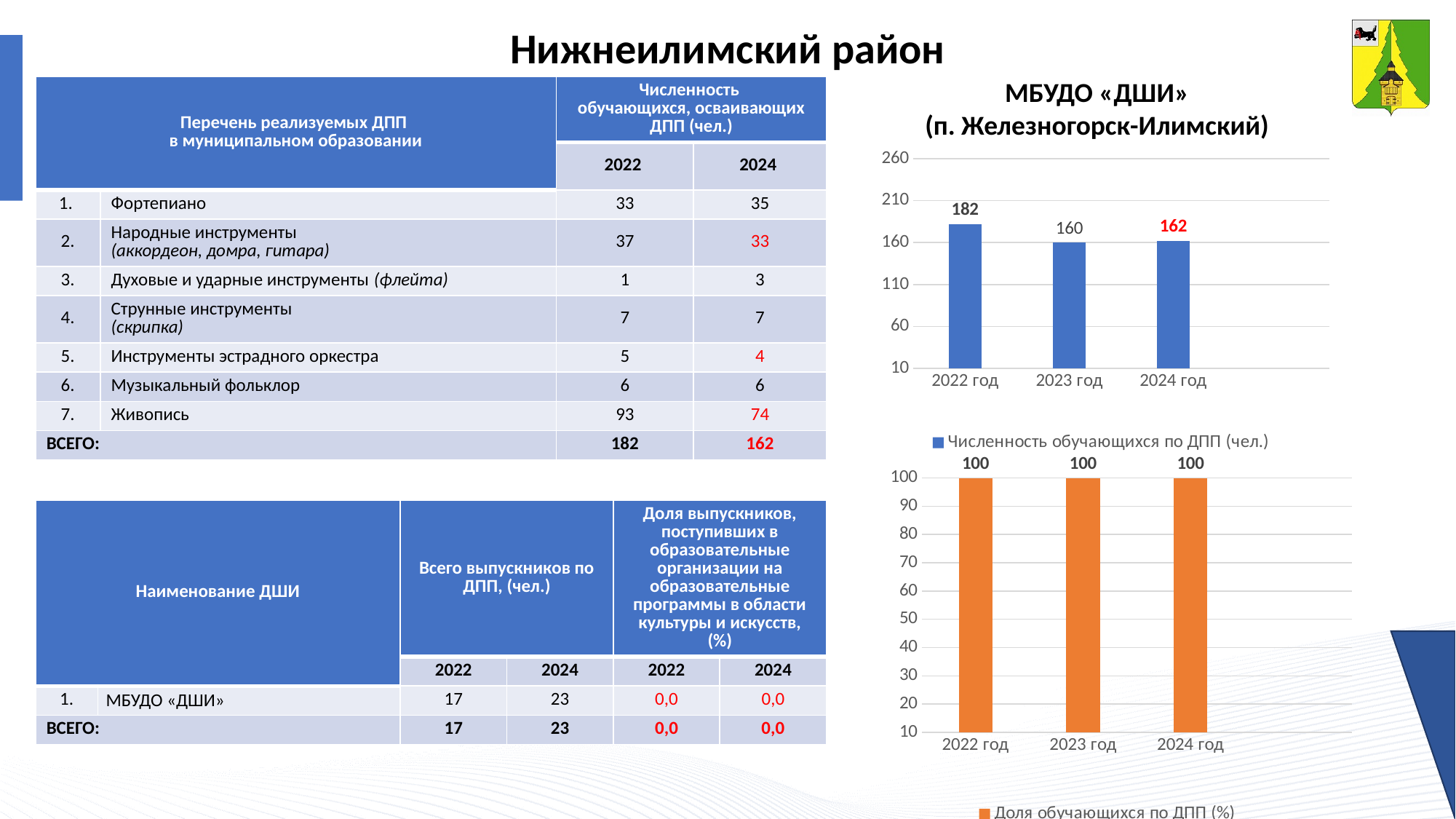
What type of chart is the bottom chart (Доля обучающихся по ДПП)? bar chart In the top chart (Численность обучающихся по ДПП), what is the difference between the values for 2022 год and 2024 год? 20 In the bottom chart (Доля обучающихся по ДПП), what is the value for 2023 год? 100 In the top chart (Численность обучающихся по ДПП), is the value for 2022 год greater or less than 160? greater How many bars are shown in the top chart (Численность обучающихся по ДПП)? 3 In the top chart (Численность обучающихся по ДПП), what is the value for 2023 год? 160 In the top chart (Численность обучающихся по ДПП), what is the value for 2024 год? 162 What colour are the bars in the bottom chart (Доля обучающихся по ДПП)? orange In the top chart (Численность обучающихся по ДПП), which year has the highest value? 2022 год In the bottom chart (Доля обучающихся по ДПП), do the values rise, fall or stay the same from 2022 год to 2024 год? stay the same In the top chart (Численность обучающихся по ДПП), what is the value for 2022 год? 182 In the top chart (Численность обучающихся по ДПП), which year has the lowest value? 2023 год